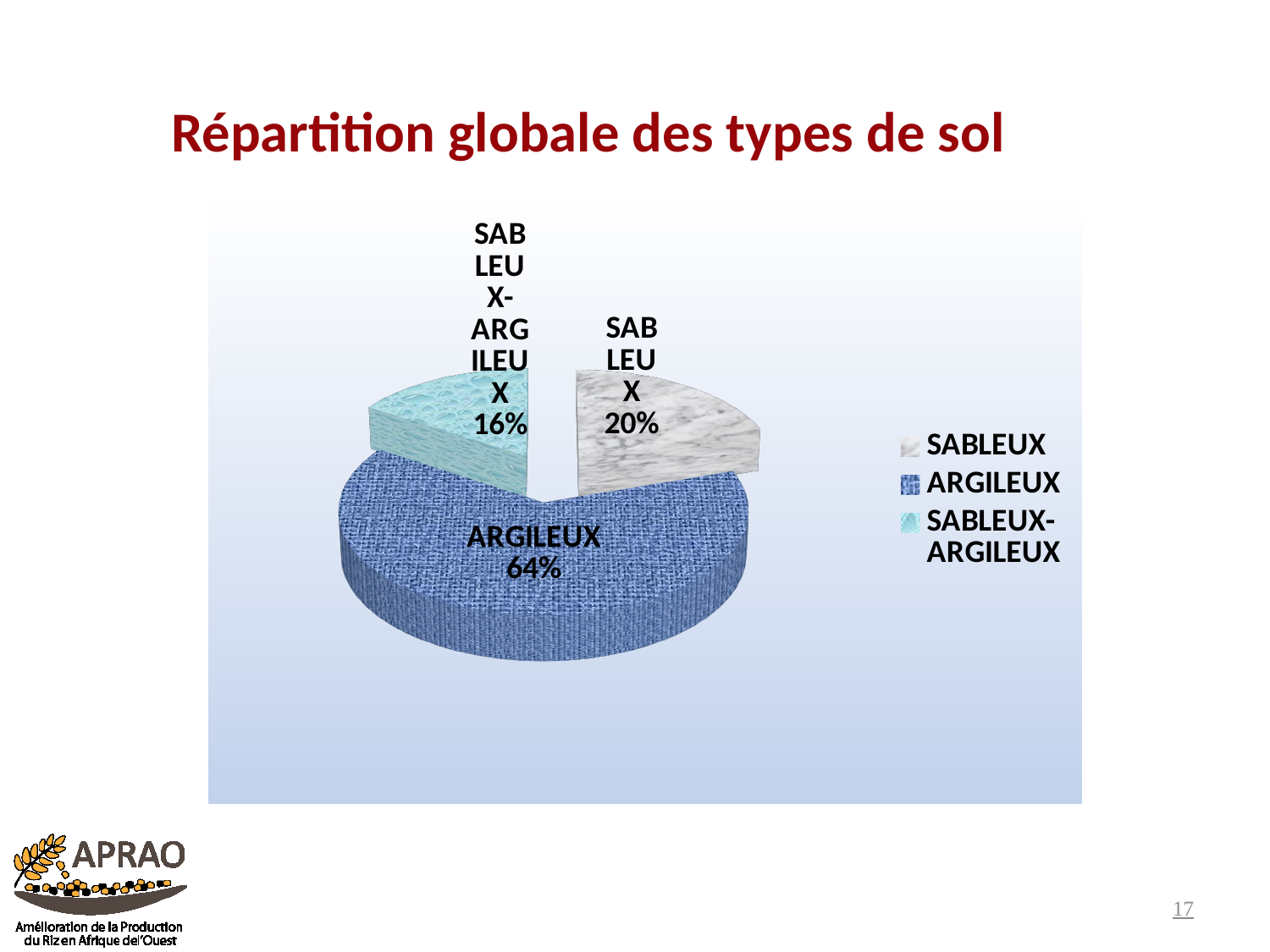
What is the difference in percentage points between the ARGILEUX and SABLEUX shares? 44 Which soil type has the smallest share of the pie? SABLEUX-ARGILEUX What is the title of the slide? Répartition globale des types de sol Which soil type has the largest share of the pie? ARGILEUX Which has a larger share, SABLEUX or SABLEUX-ARGILEUX? SABLEUX What share of the pie does SABLEUX-ARGILEUX represent? 16% What share of the pie does ARGILEUX represent? 64% What kind of chart is shown on the slide? Pie chart How many entries does the legend list? 3 How many slices does the pie chart have? 3 What share of the pie does SABLEUX represent? 20% What is the difference in percentage points between the SABLEUX and SABLEUX-ARGILEUX shares? 4